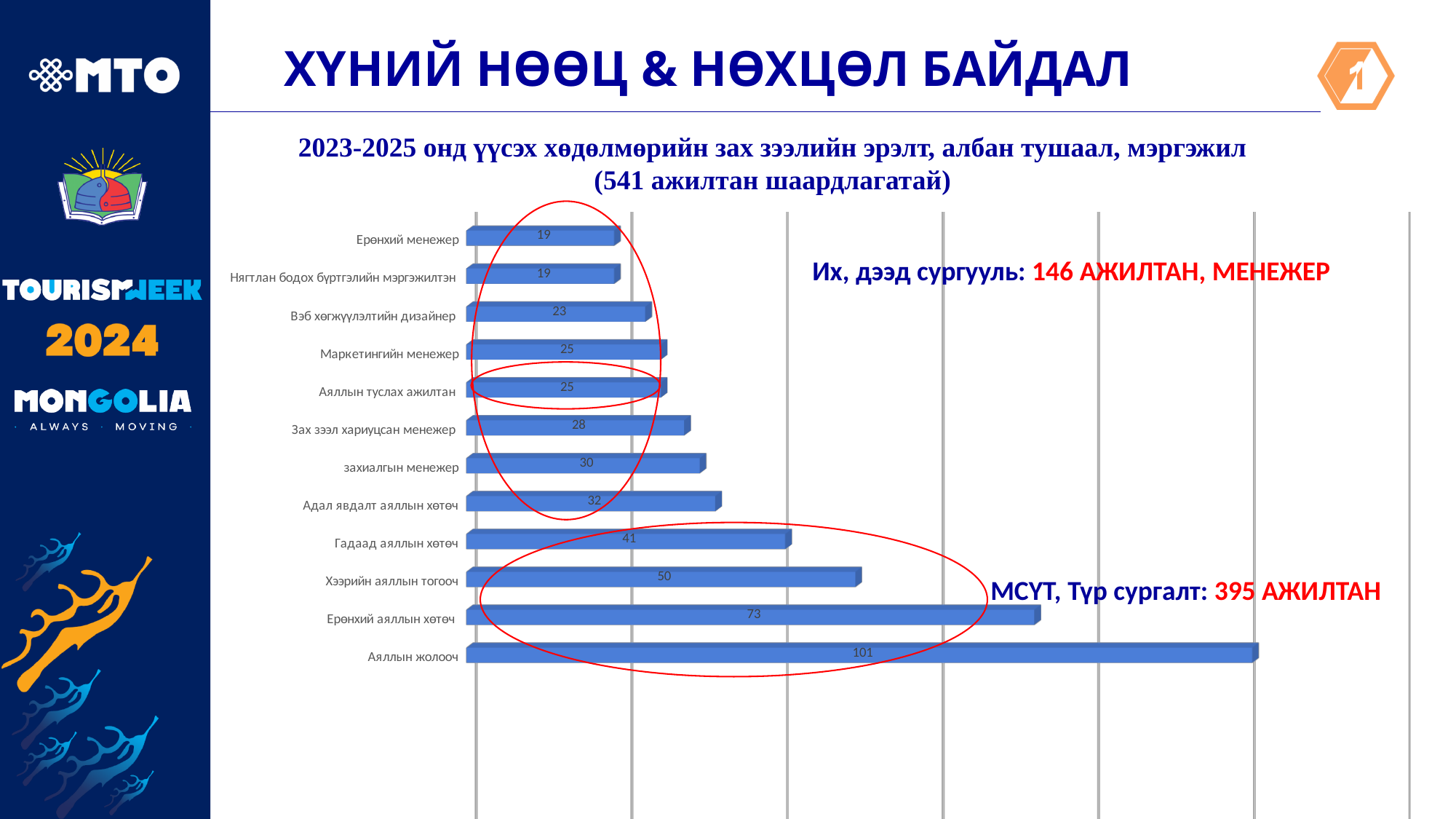
What value is shown for Ерөнхий аяллын хөтөч? 73 What kind of chart is shown on the slide? Bar chart What value is shown for Вэб хөгжүүлэлтийн дизайнер? 23 What is the difference between the values for Гадаад аяллын хөтөч and Адал явдалт аяллын хөтөч? 9 What total number of employees is stated in the chart title? 541 What is the difference between the values for Аяллын жолооч and Ерөнхий аяллын хөтөч? 28 Which category has the highest value? Аяллын жолооч Which is larger, the value for захиалгын менежер or the value for Зах зээл хариуцсан менежер? захиалгын менежер Which is larger, the value for Хээрийн аяллын тогооч or the value for Гадаад аяллын хөтөч? Хээрийн аяллын тогооч What value is shown for Аяллын жолооч? 101 What value is shown for Хээрийн аяллын тогооч? 50 How many categories are shown in the chart? 12